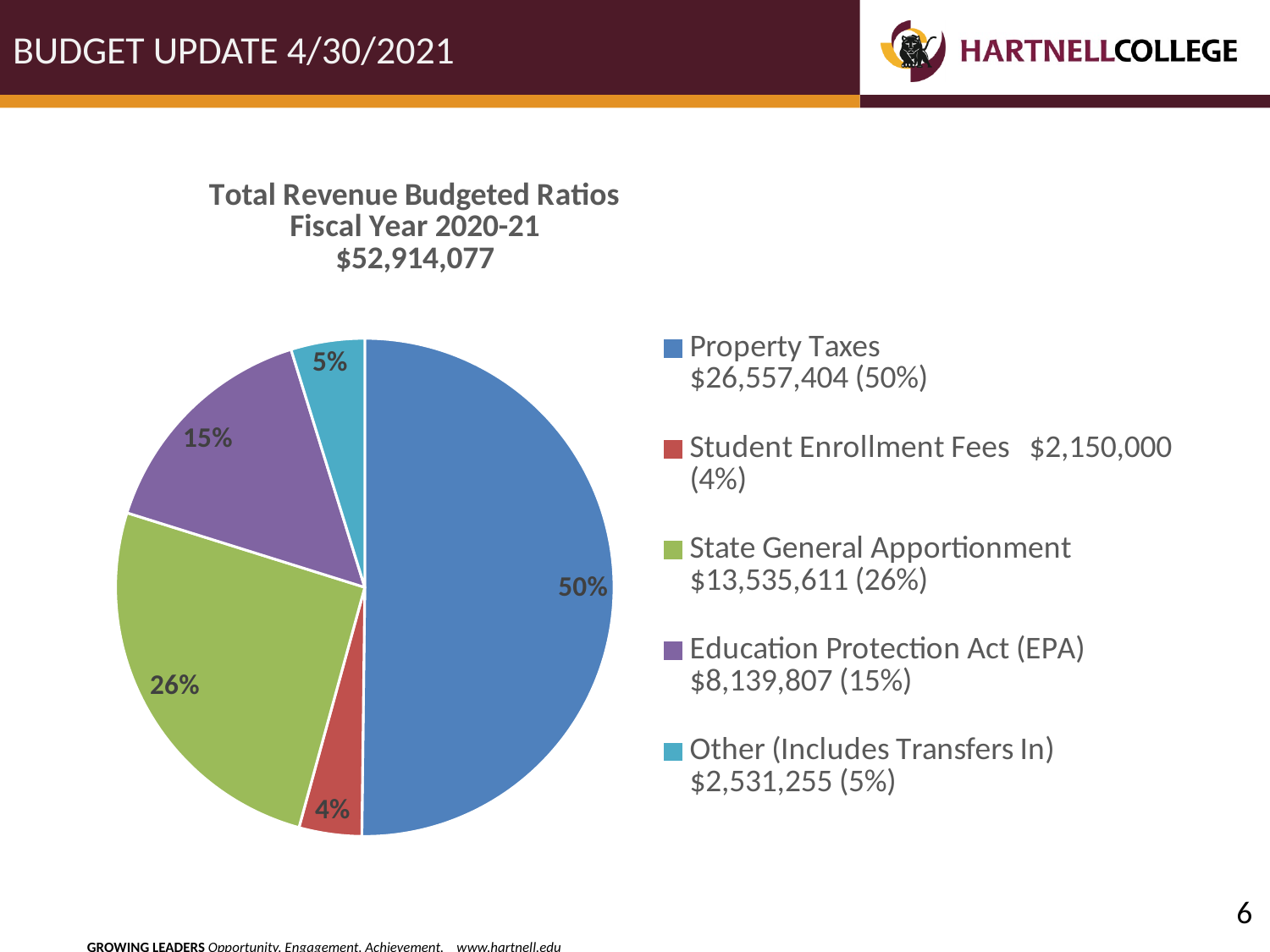
What share of the pie does State General Apportionment represent? 26% What type of chart is shown on the slide? pie chart Which is larger, the share for State General Apportionment or the share for Education Protection Act (EPA)? State General Apportionment What share of the pie does Student Enrollment Fees represent? 4% Which category has the largest slice of the pie? Property Taxes What share of the pie does Property Taxes represent? 50% How many categories does the pie chart show? 5 What is the difference in percentage points between the Property Taxes share and the State General Apportionment share? 24 percentage points What total dollar amount is shown in the chart title? $52,914,077 What colour is the slice for Other (Includes Transfers In)? light blue Which category has the smallest slice of the pie? Student Enrollment Fees